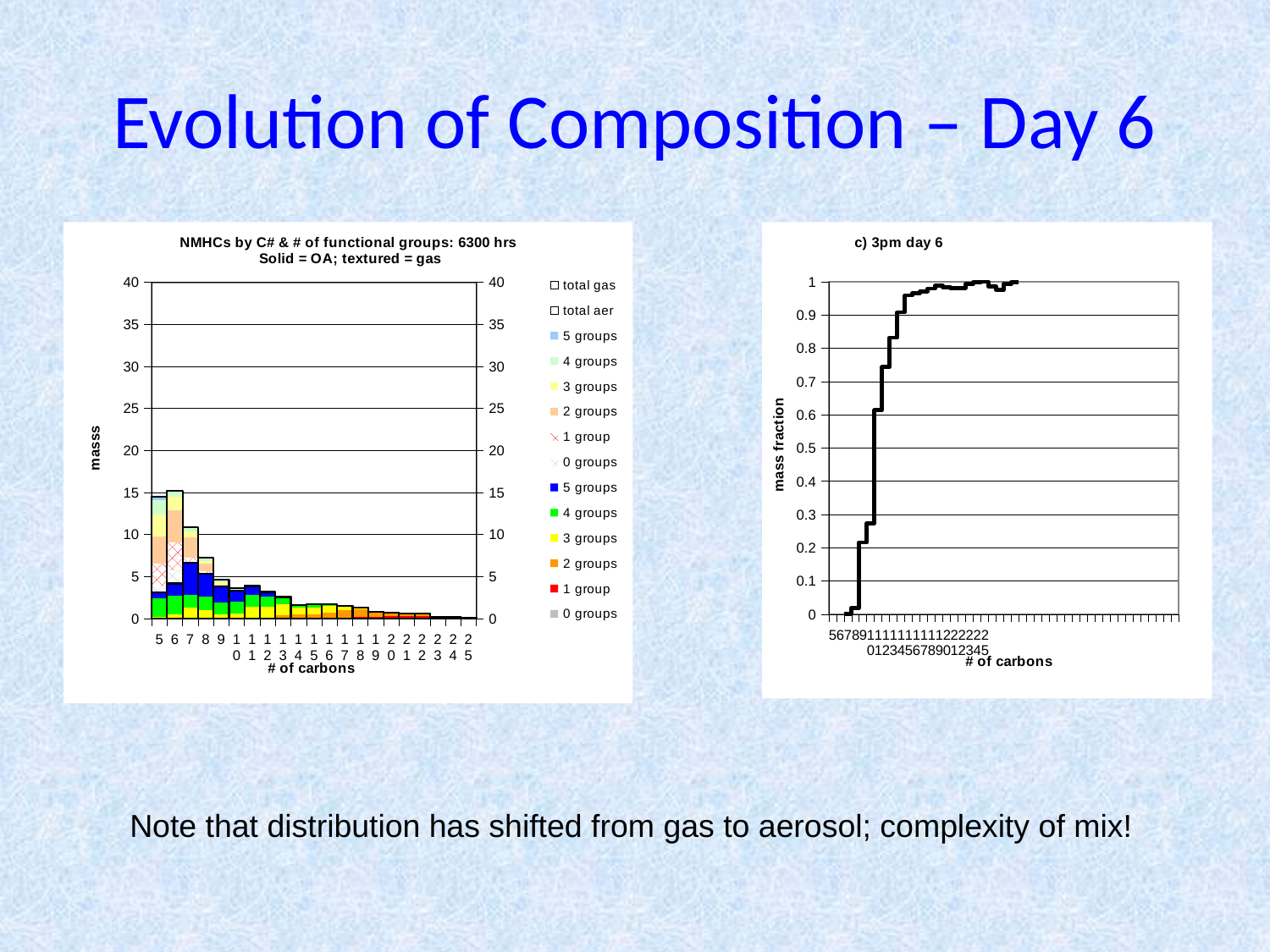
In the chart titled "c) 3pm day 6", does the mass fraction rise or fall as # of carbons increases? rise What kind of chart is the chart titled "c) 3pm day 6"? line chart In the left chart, which is larger, the total bar for 6 carbons or the total bar for 8 carbons? 6 carbons In the left chart, how many # of carbons categories are shown on the x axis? 21 What kind of chart is the chart on the left of the slide? bar chart In the left chart, how many entries does the legend list? 14 In the chart titled "c) 3pm day 6", is the mass fraction at 25 carbons greater or less than 0.9? greater In the chart titled "c) 3pm day 6", is the mass fraction at 5 carbons greater or less than 0.1? less In the left chart, what is the label of the y axis? masss In the left chart, is the total bar height for 25 carbons greater or less than 5? less